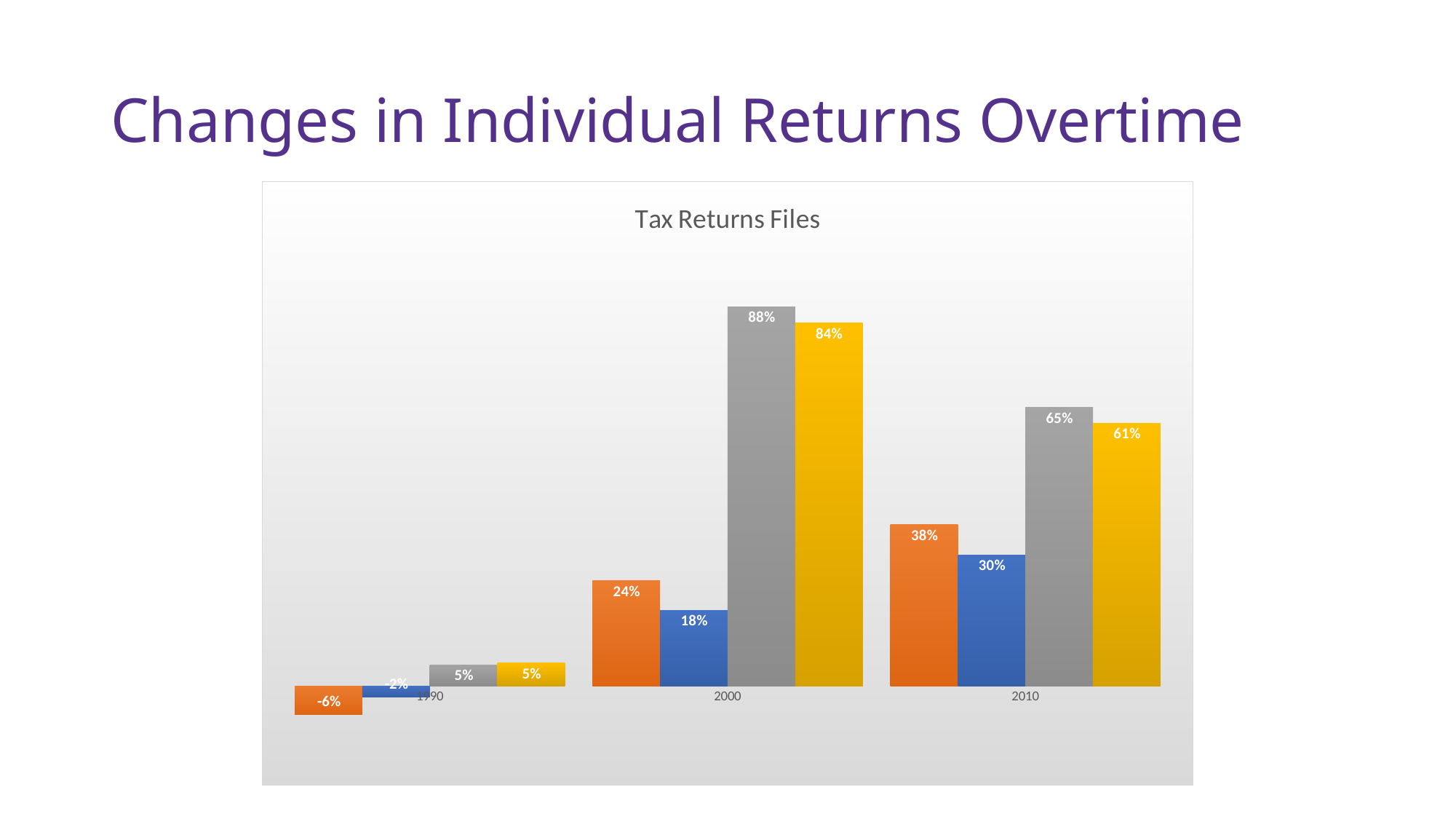
What is the value of the yellow bar for 2000? 84% What is the value of the blue bar for 2010? 30% What kind of chart is shown on the slide? bar chart In which year is the orange bar at its lowest value? 1990 How many bars are plotted for each year category in the chart? 4 What is the title of the chart? Tax Returns Files How many year categories are shown on the x axis of the chart? 3 What is the value of the orange bar for 1990? -6% In which year does the gray bar reach its highest value? 2000 What is the value of the gray bar for 2000? 88% What is the difference between the gray bar and the yellow bar for 2010? 4% Which is larger for 2010, the orange bar or the blue bar? the orange bar